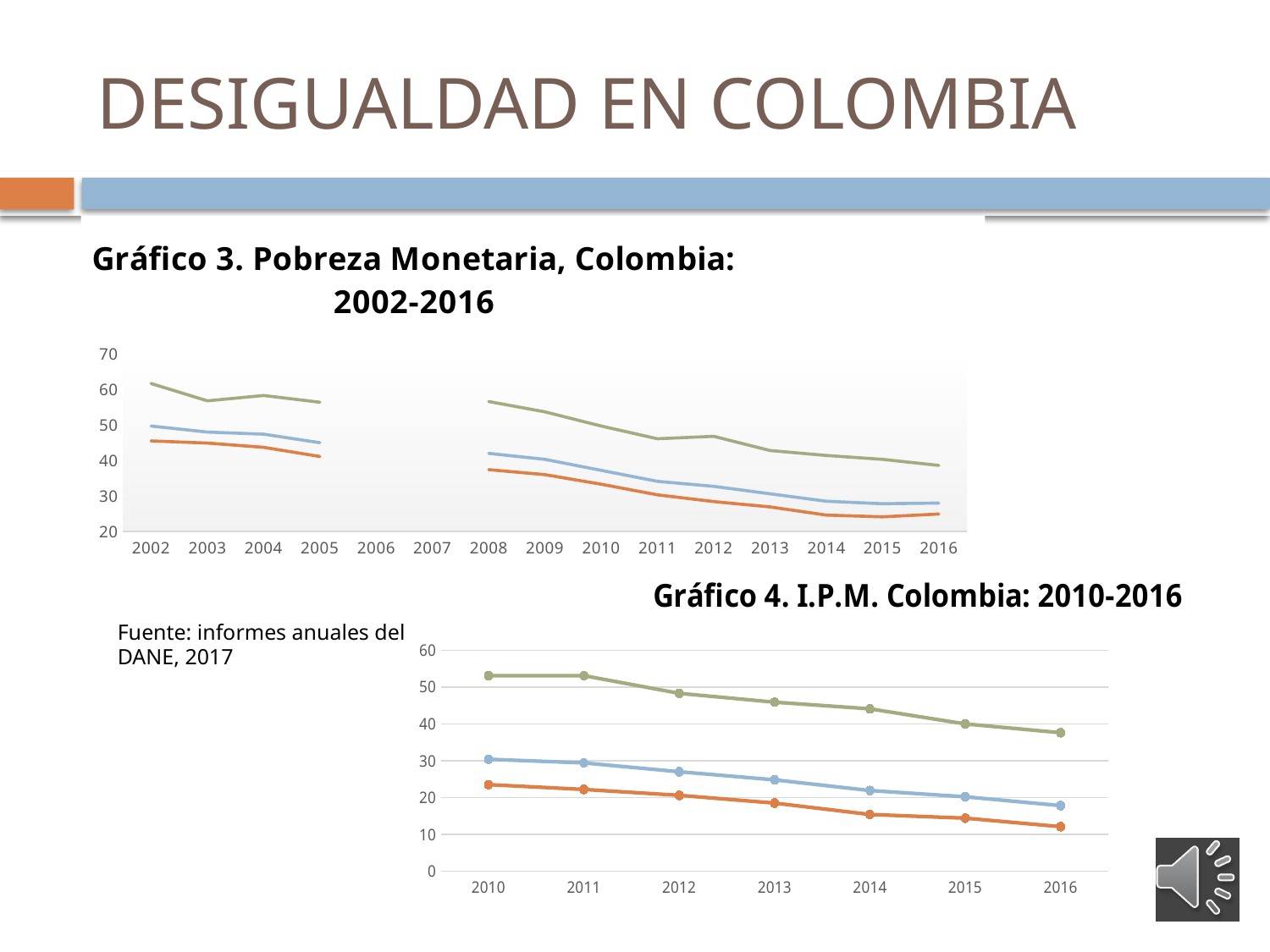
In Gráfico 4. I.P.M. Colombia: 2010-2016, is the value of the orange line in 2016 greater or less than 20? less In Gráfico 3. Pobreza Monetaria, Colombia: 2002-2016, is the value of the blue line in 2016 greater or less than 30? less In Gráfico 4. I.P.M. Colombia: 2010-2016, do the values of the green line rise or fall from 2010 to 2016? fall In Gráfico 4. I.P.M. Colombia: 2010-2016, how many years are shown on the x axis? 7 What kind of chart is Gráfico 3. Pobreza Monetaria, Colombia: 2002-2016? line chart In Gráfico 3. Pobreza Monetaria, Colombia: 2002-2016, do the values of the orange line rise or fall from 2008 to 2016? fall In Gráfico 4. I.P.M. Colombia: 2010-2016, is the value of the green line in 2010 greater or less than 50? greater In Gráfico 3. Pobreza Monetaria, Colombia: 2002-2016, which years on the x axis have no data plotted? 2006 and 2007 In Gráfico 4. I.P.M. Colombia: 2010-2016, which line has the higher value in 2016, the green line or the blue line? the green line What is the title of the lower chart on the slide? Gráfico 4. I.P.M. Colombia: 2010-2016 What kind of chart is Gráfico 4. I.P.M. Colombia: 2010-2016? line chart